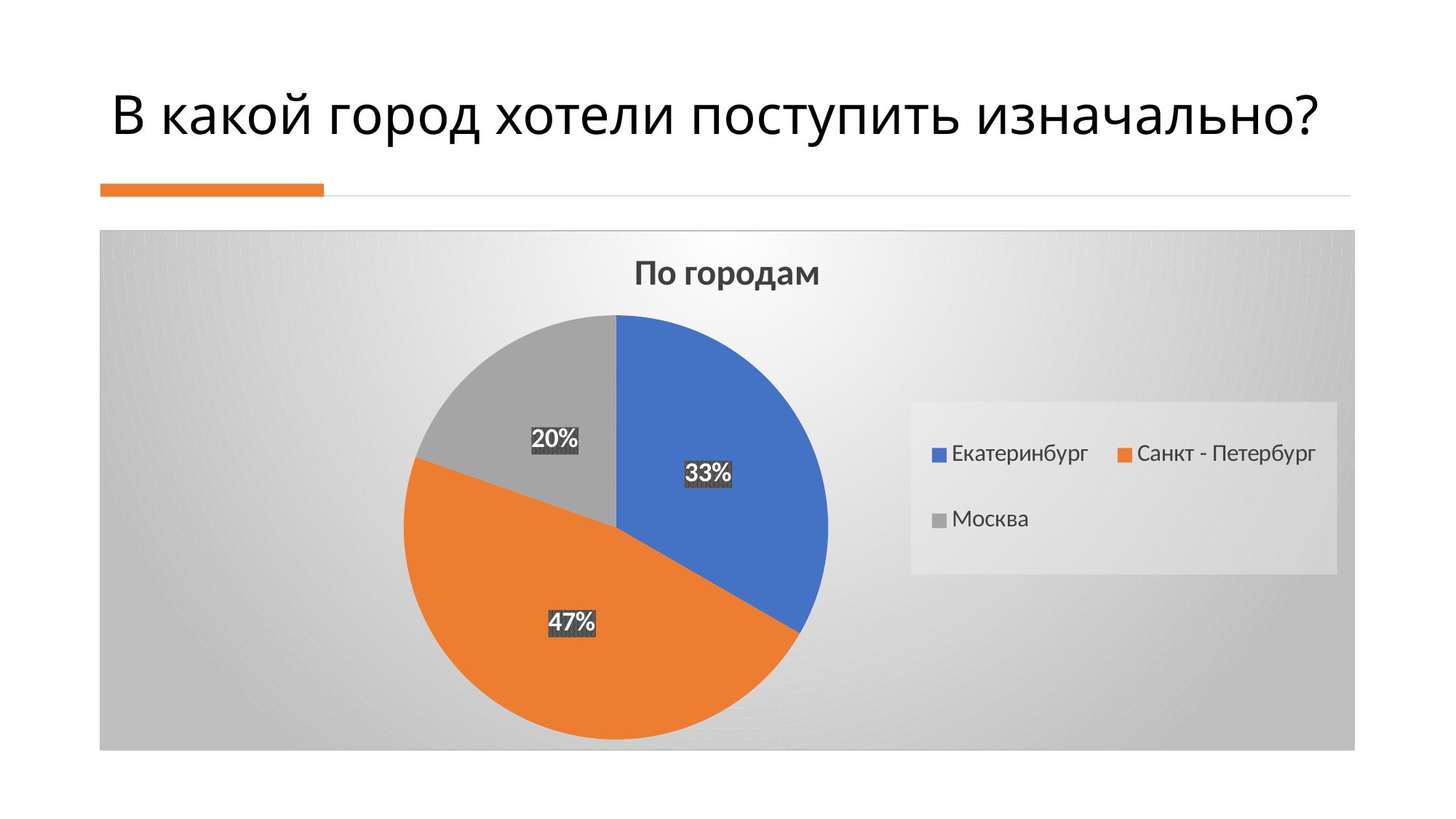
What share of the pie does Москва have? 20% What kind of chart is shown on the slide? Pie chart How many categories does the pie chart have? 3 What share of the pie does Екатеринбург have? 33% What share of the pie does Санкт - Петербург have? 47% Which city has the smallest slice of the pie? Москва What is the title of the chart? По городам Which city has the largest slice of the pie? Санкт - Петербург What is the difference in percentage points between Санкт - Петербург and Екатеринбург? 14 What colour is the slice for Санкт - Петербург? Orange Which is larger, the slice for Екатеринбург or the slice for Москва? Екатеринбург What is the difference in percentage points between Екатеринбург and Москва? 13